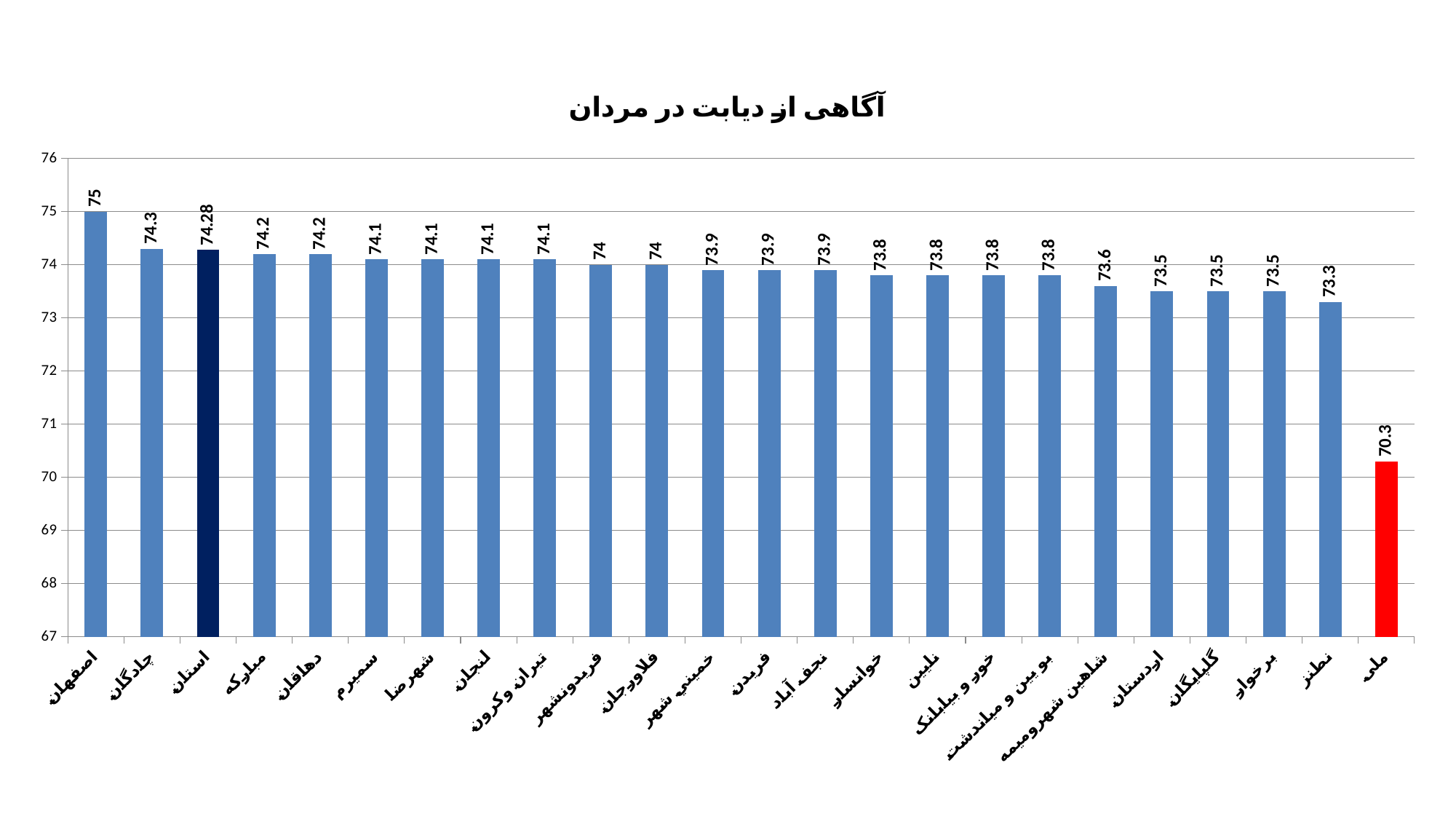
What kind of chart is this? bar chart What is the value for ملی? 70.3 Which category has the highest value? اصفهان What is the title of the chart? آگاهی از دیابت در مردان What is the value for اصفهان? 75 What is the value for نطنز? 73.3 How many categories are shown on the x axis? 24 Is the value for ملی greater or less than 71? less What is the value for استان? 74.28 What is the difference between the values for اصفهان and ملی? 4.7 Which is larger, the value for چادگان or the value for شاهین شهر و میمه? چادگان Which category has the lowest value? ملی